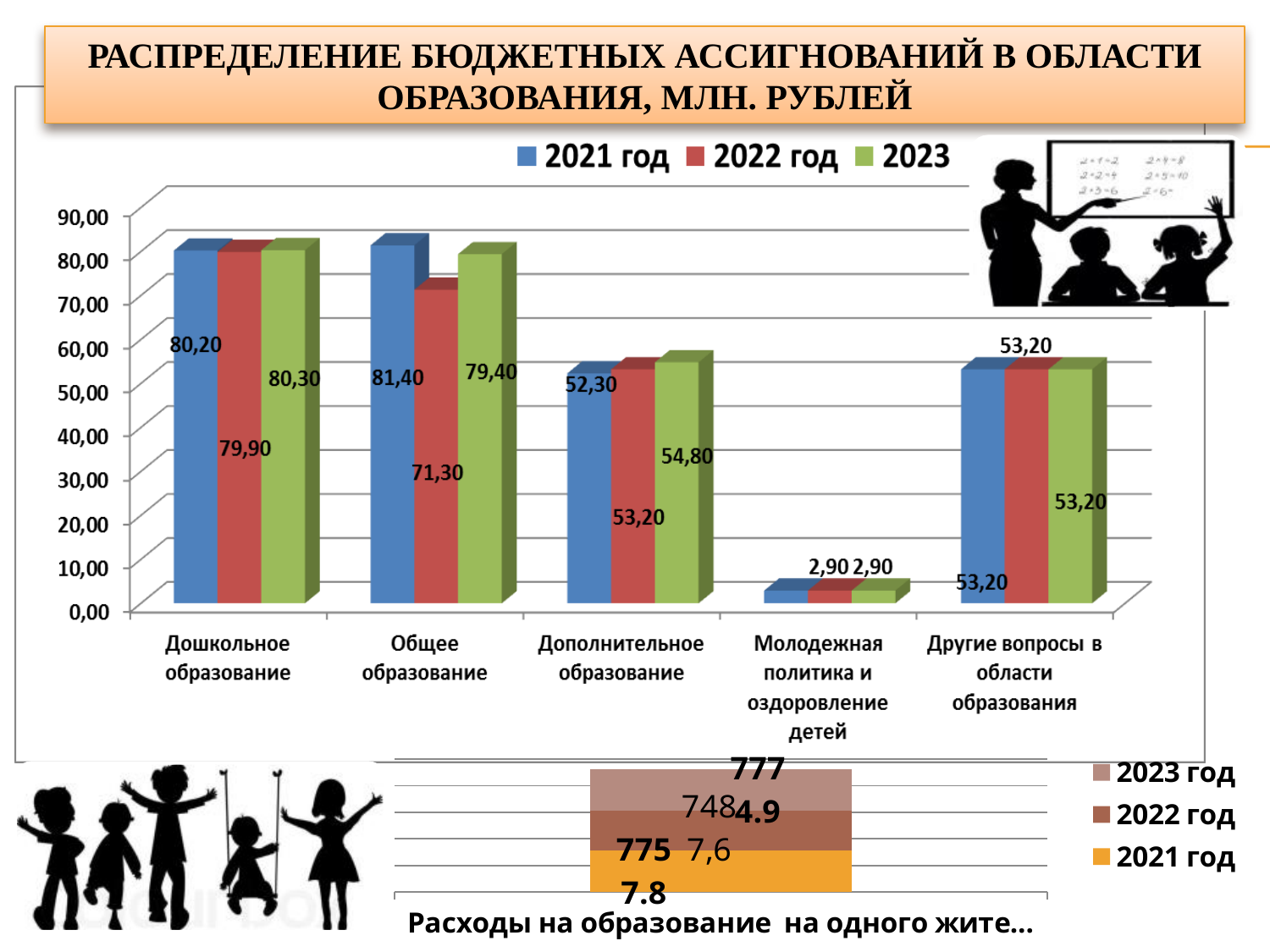
In the top chart, what is the value for Другие вопросы в области образования in 2021 год? 53,20 In the top chart, what is the value for Общее образование in 2022 год? 71,30 How many series does the legend of the top chart list? 3 In the top chart, what is the difference between the 2021 год and 2022 год values for Общее образование? 10,10 In the top chart, is the 2022 год value for Общее образование greater or less than 80,00? less In the top chart, which category has the lowest values across all years? Молодежная политика и оздоровление детей In the top chart, what is the value for Дополнительное образование in 2023? 54,80 What kind of chart is the top chart on the slide? bar chart In the top chart, which category has the highest value for 2021 год? Общее образование How many categories are shown on the x axis of the top chart? 5 In the top chart (Распределение бюджетных ассигнований в области образования), what is the value for Дошкольное образование in 2021 год? 80,20 In the top chart, which is larger for Дополнительное образование: the 2021 год value or the 2023 value? 2023